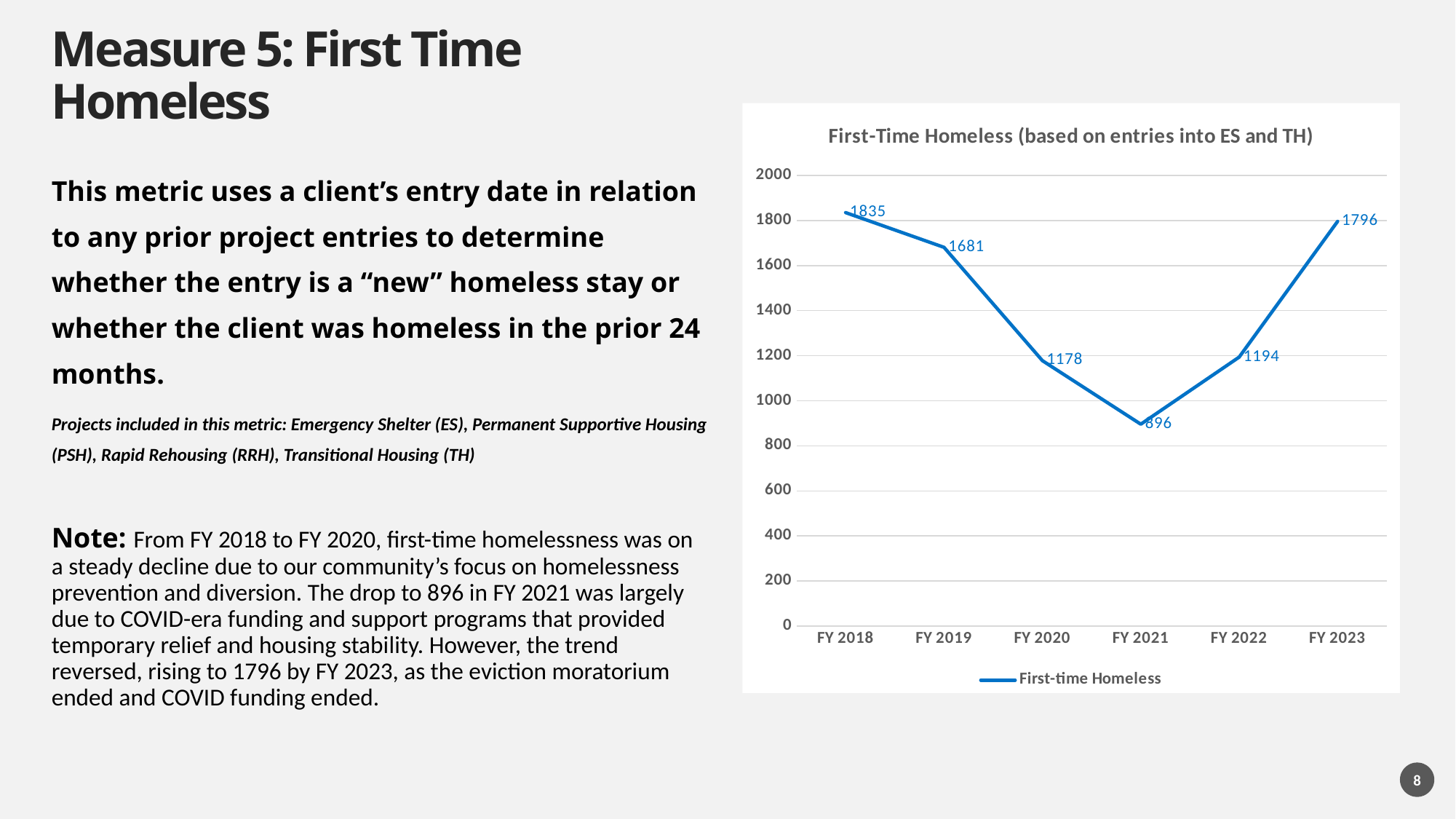
What is the value for FY 2021? 896 What is the difference between the FY 2023 value and the FY 2021 value? 900 How many series does the legend list? 1 Which is larger, the value for FY 2020 or the value for FY 2022? FY 2022 What is the value for FY 2018? 1835 How many fiscal years are plotted on the x axis? 6 Do the values rise or fall from FY 2018 to FY 2021? fall What kind of chart is shown? line chart What is the value for FY 2022? 1194 Which fiscal year has the lowest value? FY 2021 Which fiscal year has the highest value? FY 2018 Is the value for FY 2019 greater or less than 1600? greater